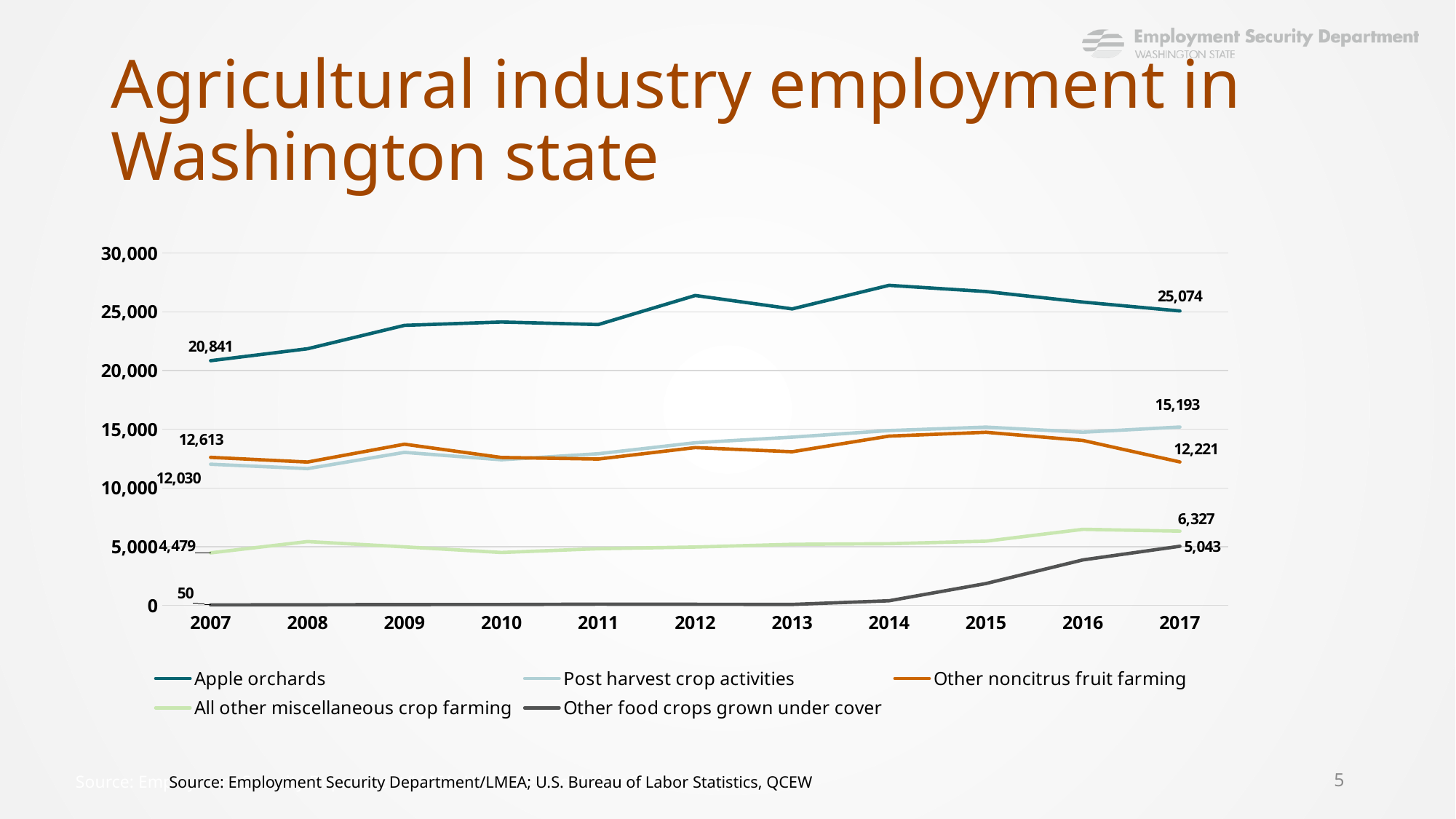
What was employment in Post harvest crop activities in 2017? 15,193 Which series had the lowest employment in 2007? Other food crops grown under cover What was employment in Other food crops grown under cover in 2007? 50 What was employment in Apple orchards in 2017? 25,074 Which series had the highest employment in 2017? Apple orchards What type of chart is shown on the slide? line chart What is the difference between Apple orchards employment in 2017 and in 2007? 4,233 How many years are shown on the x axis? 11 In 2017, which was larger: Post harvest crop activities or Other noncitrus fruit farming? Post harvest crop activities Is the value for Apple orchards in 2014 greater or less than 25,000? greater How many series does the legend list? 5 Did employment in Other food crops grown under cover rise or fall from 2007 to 2017? rise